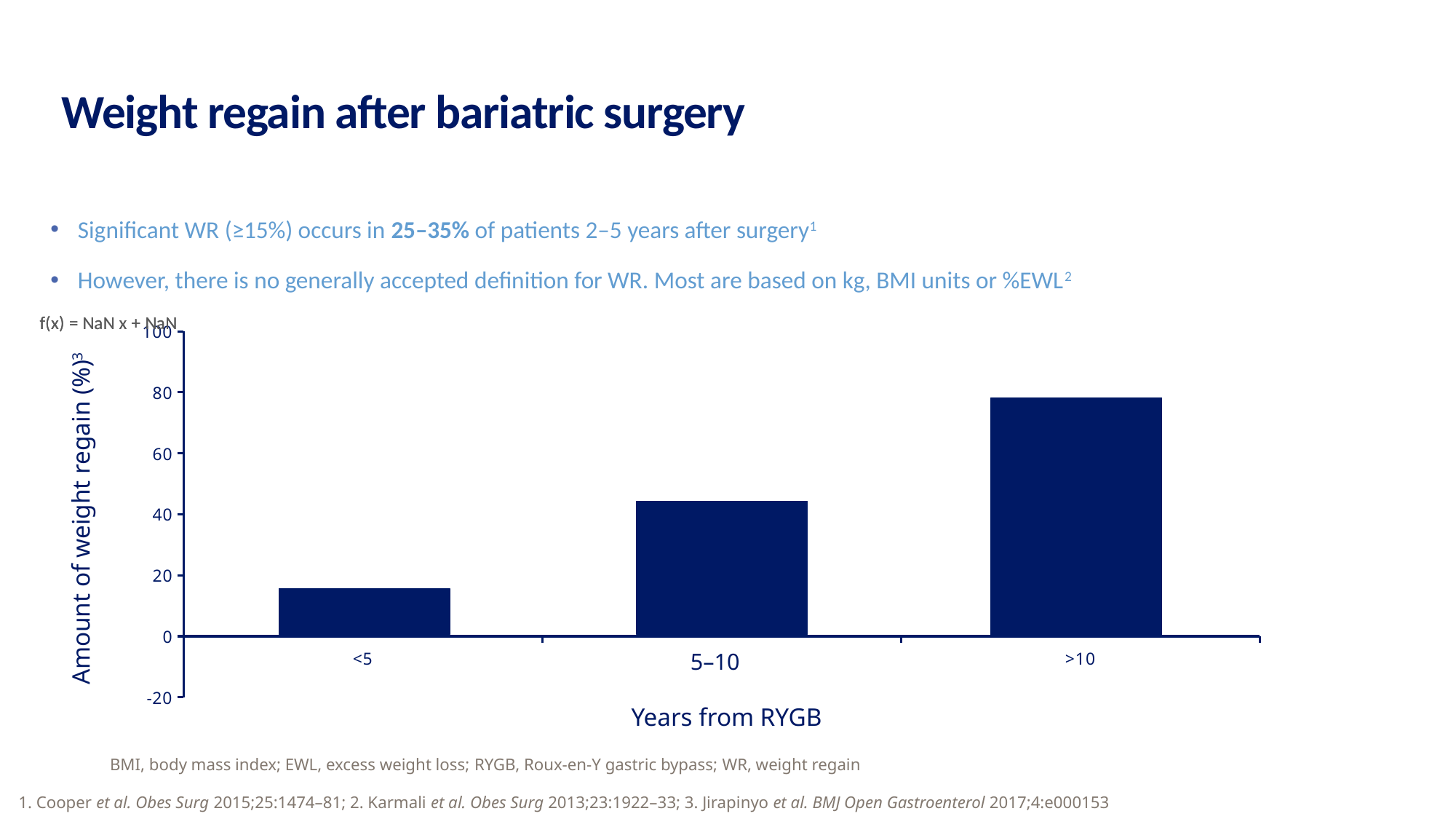
What is the label of the y axis of the chart? Amount of weight regain (%) Which category has the highest amount of weight regain? >10 Is the value for >10 years from RYGB greater or less than 60? greater Is the value for 5–10 years from RYGB greater or less than 20? greater What is the label of the x axis of the chart? Years from RYGB Do the values rise or fall as years from RYGB increase along the x axis? rise Which category has the lowest amount of weight regain? <5 What kind of chart is shown on the slide? bar chart Which is larger, the value for 5–10 years or the value for >10 years from RYGB? >10 Is the value for 5–10 years from RYGB greater or less than 60? less How many categories are plotted on the x axis of the chart? 3